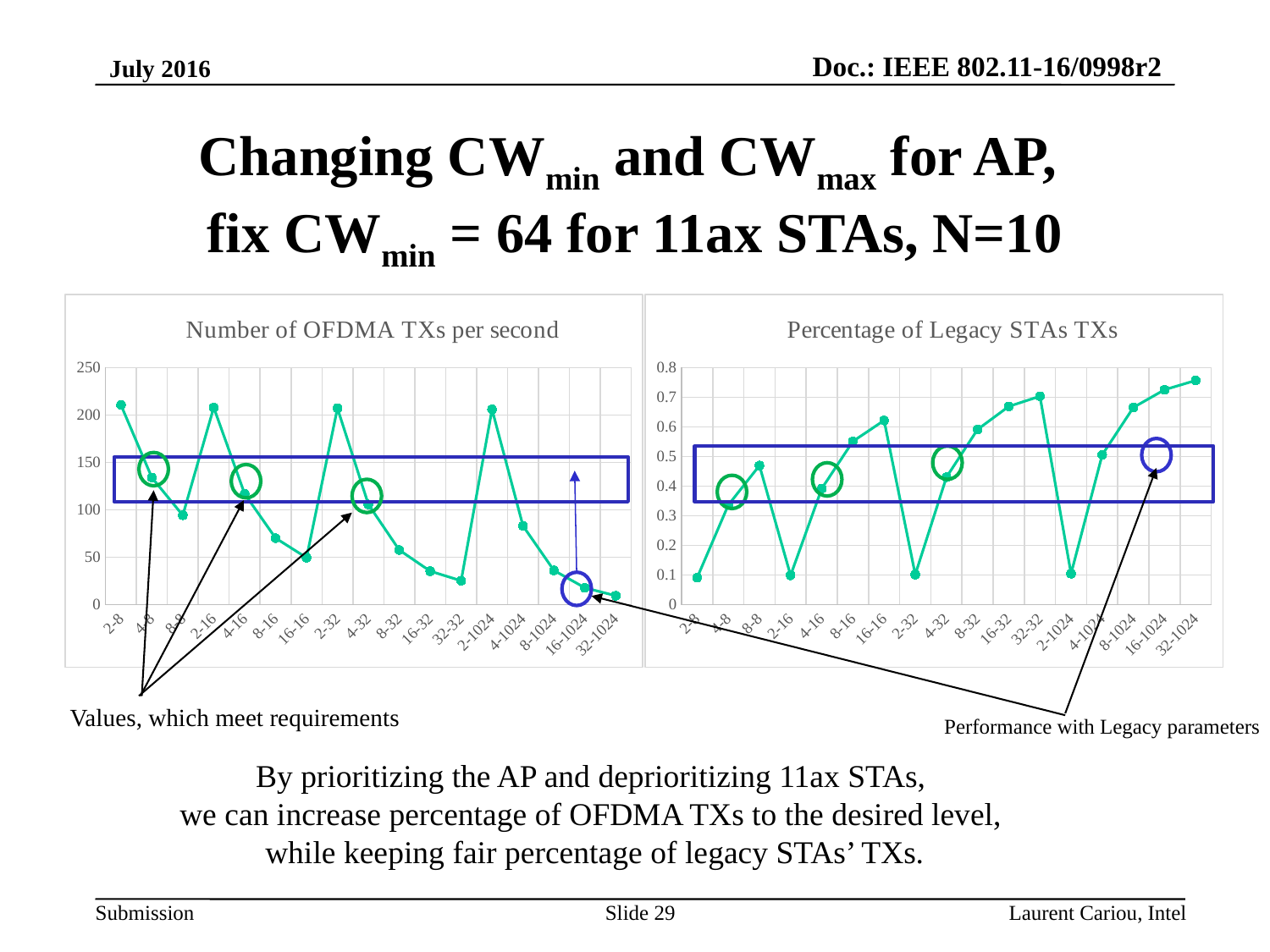
What is the title of the right chart on the slide? Percentage of Legacy STAs TXs In the left chart, "Number of OFDMA TXs per second", which is larger, the value for 2-8 or the value for 8-8? 2-8 In the left chart, "Number of OFDMA TXs per second", is the value for 2-8 greater or less than 200? greater How many categories are shown on the x axis of the right chart, "Percentage of Legacy STAs TXs"? 17 In the left chart, "Number of OFDMA TXs per second", do the values rise or fall from 2-32 to 32-32? fall In the left chart, "Number of OFDMA TXs per second", is the value for 32-1024 greater or less than 50? less In the right chart, "Percentage of Legacy STAs TXs", is the value for 16-16 greater or less than 0.5? greater In the right chart, "Percentage of Legacy STAs TXs", do the values rise or fall from 2-1024 to 32-1024? rise What kind of chart is the left chart, "Number of OFDMA TXs per second"? line chart In the right chart, "Percentage of Legacy STAs TXs", which is larger, the value for 32-1024 or the value for 2-1024? 32-1024